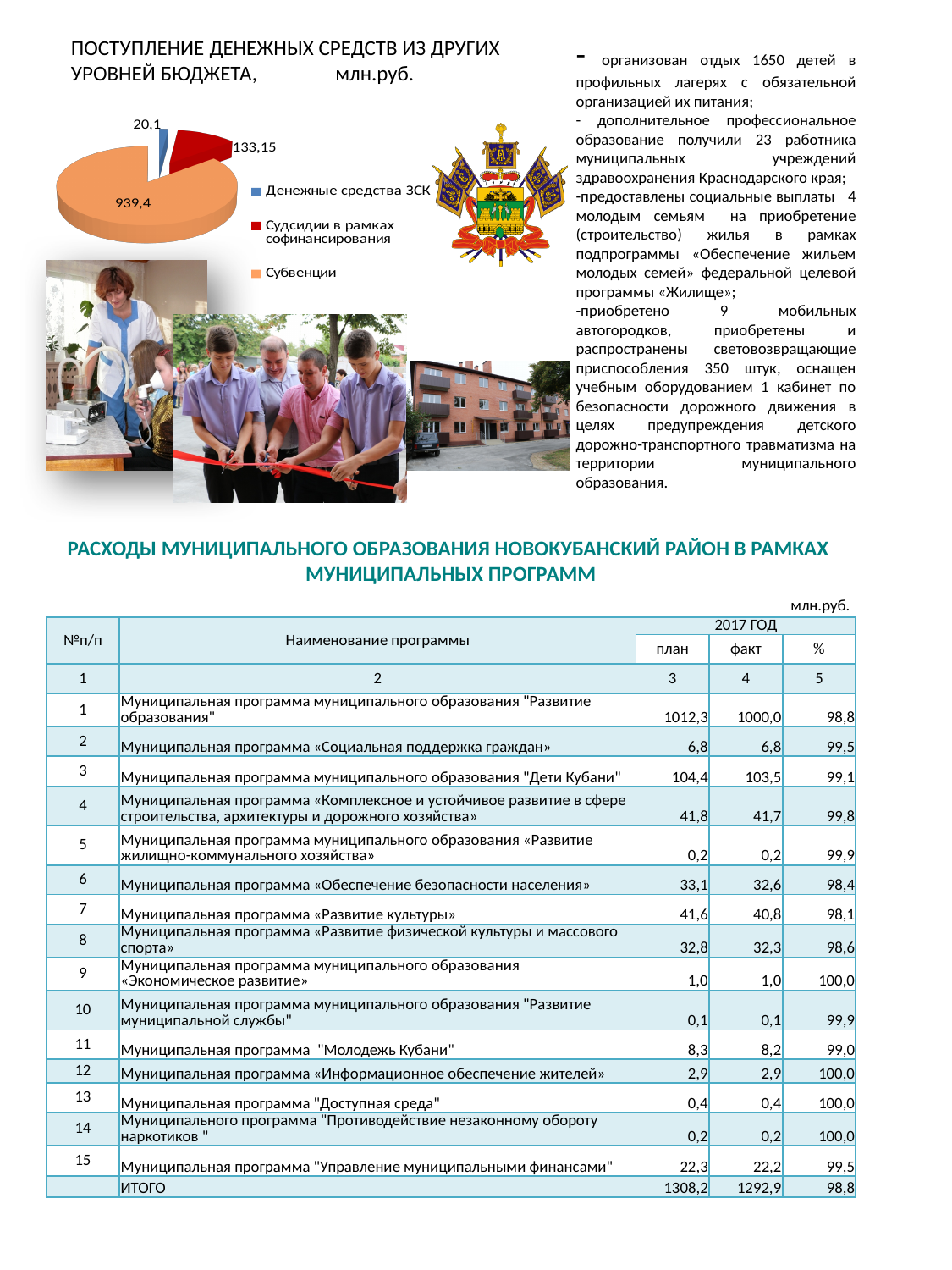
How many slices does the pie chart have? 3 What is the value for Денежные средства ЗСК in the pie chart? 20,1 Which category has the largest slice in the pie chart? Субвенции What is the difference between the values for Субвенции and Субсидии в рамках софинансирования? 806,25 What kind of chart is shown on the slide? pie chart What is the value for Субсидии в рамках софинансирования in the pie chart? 133,15 Which category has the smallest slice in the pie chart? Денежные средства ЗСК What is the difference between the values for Субсидии в рамках софинансирования and Денежные средства ЗСК? 113,05 What is the value for Субвенции in the pie chart? 939,4 Which is larger in the pie chart: Субсидии в рамках софинансирования or Денежные средства ЗСК? Субсидии в рамках софинансирования What is the total of all slices in the pie chart? 1092,65 What unit is stated in the title of the pie chart? млн.руб.